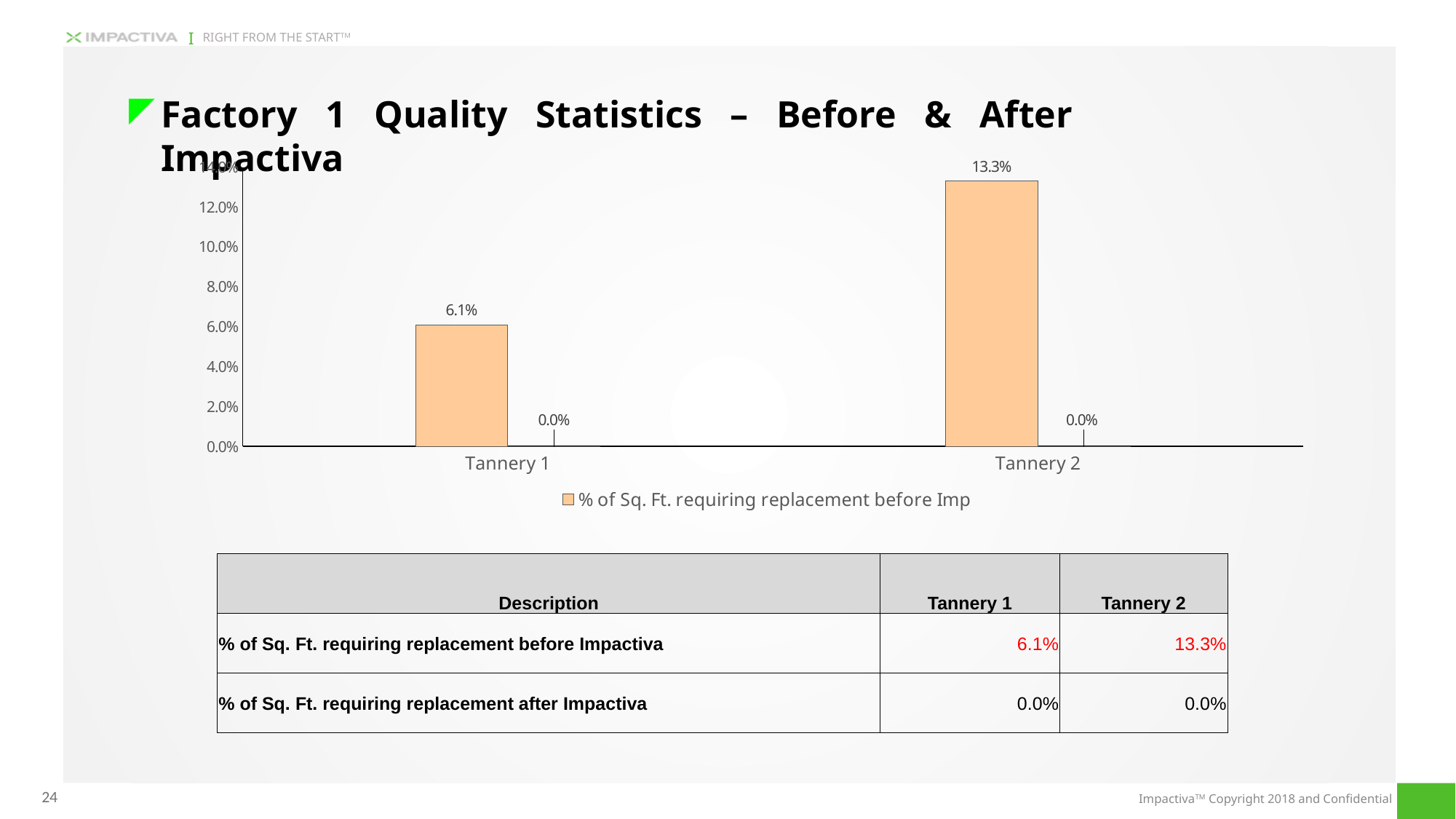
What is the difference between the Tannery 2 and Tannery 1 values for sq. ft. requiring replacement before Impactiva? 7.2% Which tannery has the lowest percentage of sq. ft. requiring replacement before Impactiva? Tannery 1 What kind of chart is shown on the slide? bar chart Is the value for Tannery 1 greater or less than 8.0%? less Is the value for Tannery 2 greater or less than 10.0%? greater How many tanneries are shown on the x axis of the chart? 2 What is the value of the bar for Tannery 1 in the chart? 6.1% What is the value of the bar for Tannery 2 in the chart? 13.3% Which is larger: the before-Impactiva value for Tannery 1 or for Tannery 2? Tannery 2 What value is labelled next to the Tannery 1 bar for the second data point (after Impactiva)? 0.0% What colour are the bars in the chart? orange Which tannery has the highest percentage of sq. ft. requiring replacement before Impactiva? Tannery 2